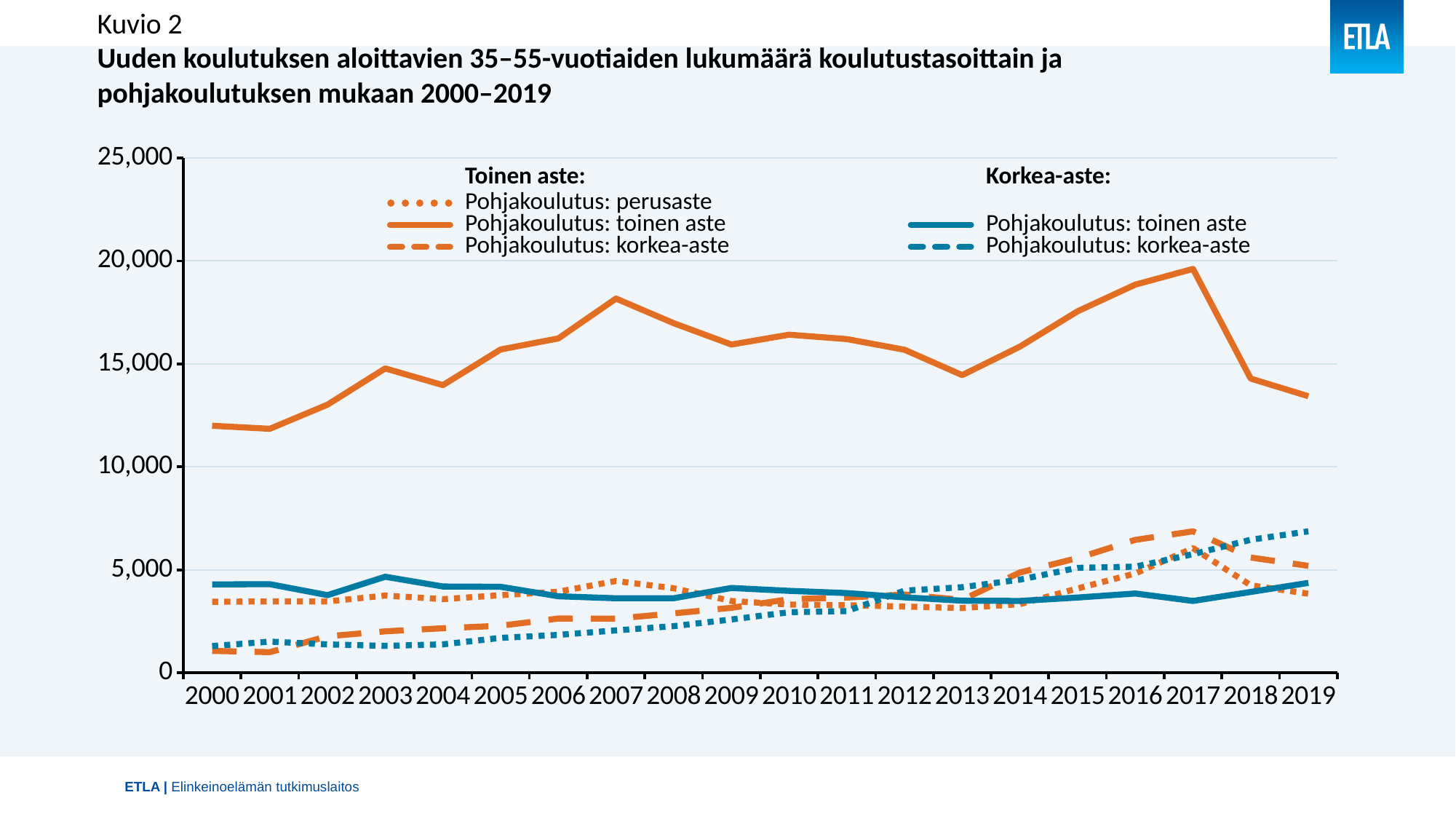
What is the highest value shown on the y axis? 25,000 Is the value for 'Korkea-aste: Pohjakoulutus: korkea-aste' in 2019 greater or less than 5,000? greater Does the series 'Korkea-aste: Pohjakoulutus: korkea-aste' rise or fall from 2000 to 2019? rise How many series does the legend list? 5 What kind of chart is shown on the slide? line chart Is the value for 'Toinen aste: Pohjakoulutus: toinen aste' in 2000 greater or less than 15,000? less Is the value for 'Toinen aste: Pohjakoulutus: perusaste' in 2000 greater or less than 5,000? less How many years are plotted along the x axis? 20 Which series has the highest values across the whole chart? Toinen aste: Pohjakoulutus: toinen aste In 2019, which is larger: 'Toinen aste: Pohjakoulutus: toinen aste' or 'Korkea-aste: Pohjakoulutus: toinen aste'? Toinen aste: Pohjakoulutus: toinen aste In which year does the series 'Toinen aste: Pohjakoulutus: toinen aste' reach its highest value? 2017